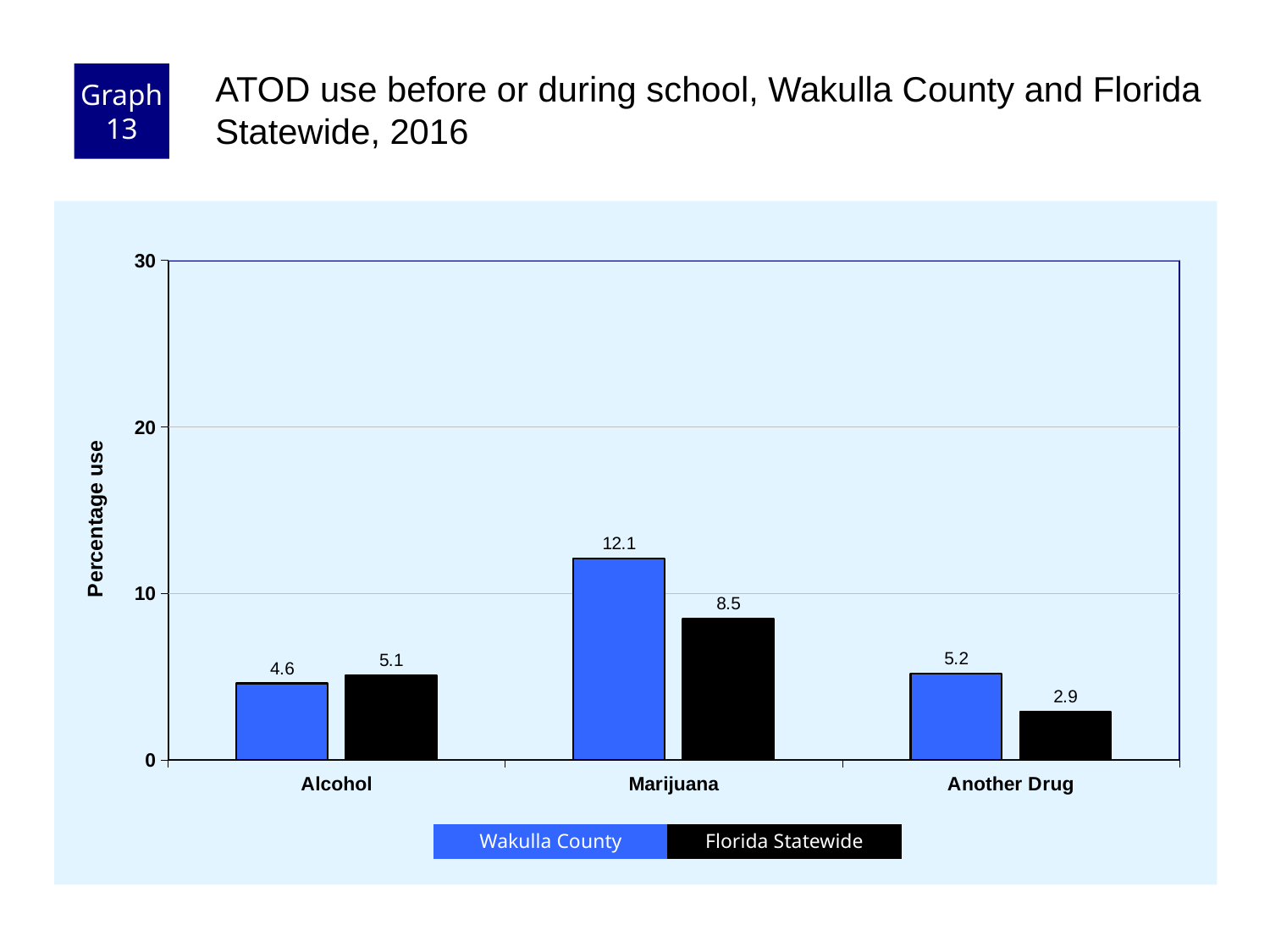
Which is larger for Alcohol, the Wakulla County value or the Florida Statewide value? Florida Statewide Is the Wakulla County value for Marijuana greater or less than 10? greater What is the Florida Statewide value for Alcohol? 5.1 What kind of chart is shown on the slide? bar chart How many categories are shown on the x axis? 3 What is the label of the y axis? Percentage use Which category has the lowest Florida Statewide value? Another Drug How many series does the legend list? 2 Which category has the highest Wakulla County value? Marijuana What is the Florida Statewide value for Another Drug? 2.9 What is the difference between the Wakulla County and Florida Statewide values for Marijuana? 3.6 What is the Wakulla County value for Marijuana? 12.1